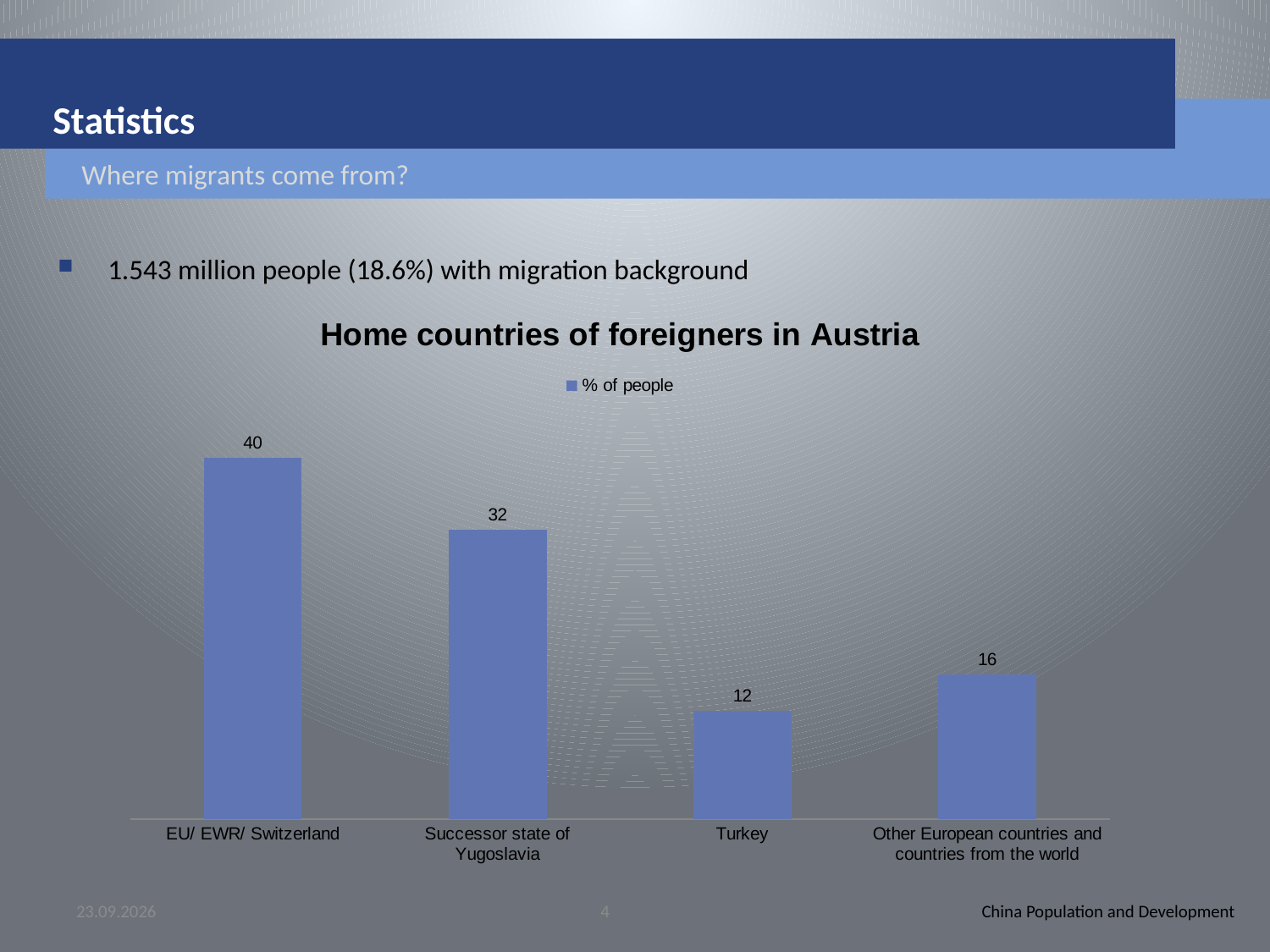
What is the value for Successor state of Yugoslavia? 32 Which is larger, the value for Turkey or the value for Other European countries and countries from the world? Other European countries and countries from the world Which category has the highest value? EU/ EWR/ Switzerland What is the difference between the values for EU/ EWR/ Switzerland and Successor state of Yugoslavia? 8 What is the value for EU/ EWR/ Switzerland? 40 How many series does the legend list? 1 What is the value for Turkey? 12 Which category has the lowest value? Turkey What is the value for Other European countries and countries from the world? 16 How many categories are shown in the chart? 4 What is the title of the chart? Home countries of foreigners in Austria What kind of chart is shown? Bar chart